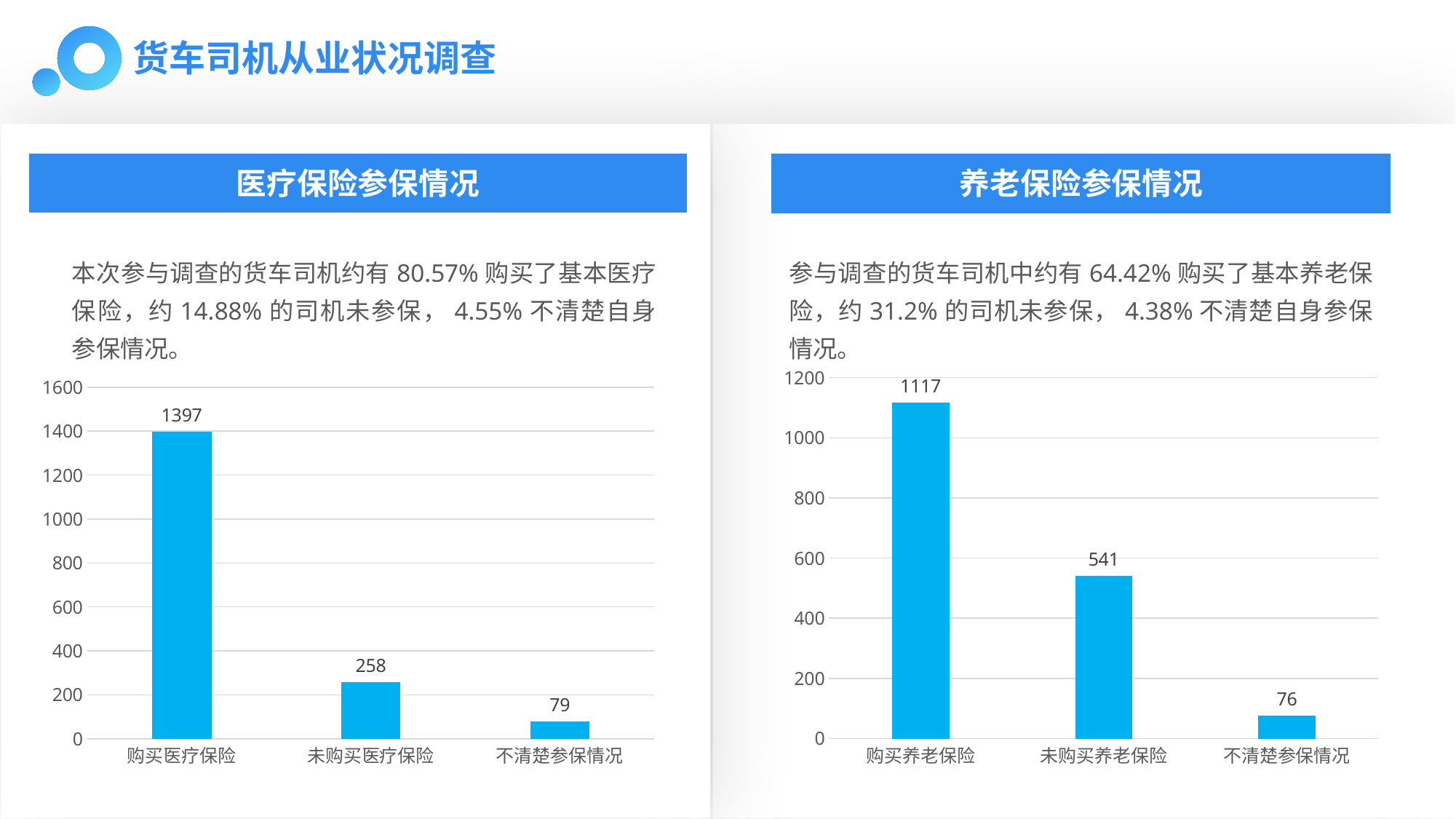
In the 医疗保险参保情况 chart, how many categories are shown? 3 Which is larger: 未购买医疗保险 in the 医疗保险参保情况 chart or 未购买养老保险 in the 养老保险参保情况 chart? 未购买养老保险 In the 医疗保险参保情况 chart, what is the value for 未购买医疗保险? 258 In the 医疗保险参保情况 chart, what is the value for 购买医疗保险? 1397 In the 医疗保险参保情况 chart, what is the difference between 购买医疗保险 and 未购买医疗保险? 1139 In the 养老保险参保情况 chart, what is the value for 购买养老保险? 1117 In the 养老保险参保情况 chart, is the value for 未购买养老保险 greater or less than 600? less What type of chart is the 养老保险参保情况 chart? bar chart In the 养老保险参保情况 chart, what is the value for 不清楚参保情况? 76 In the 医疗保险参保情况 chart, which category has the lowest value? 不清楚参保情况 In the 养老保险参保情况 chart, what is the difference between 未购买养老保险 and 不清楚参保情况? 465 In the 养老保险参保情况 chart, which category has the highest value? 购买养老保险